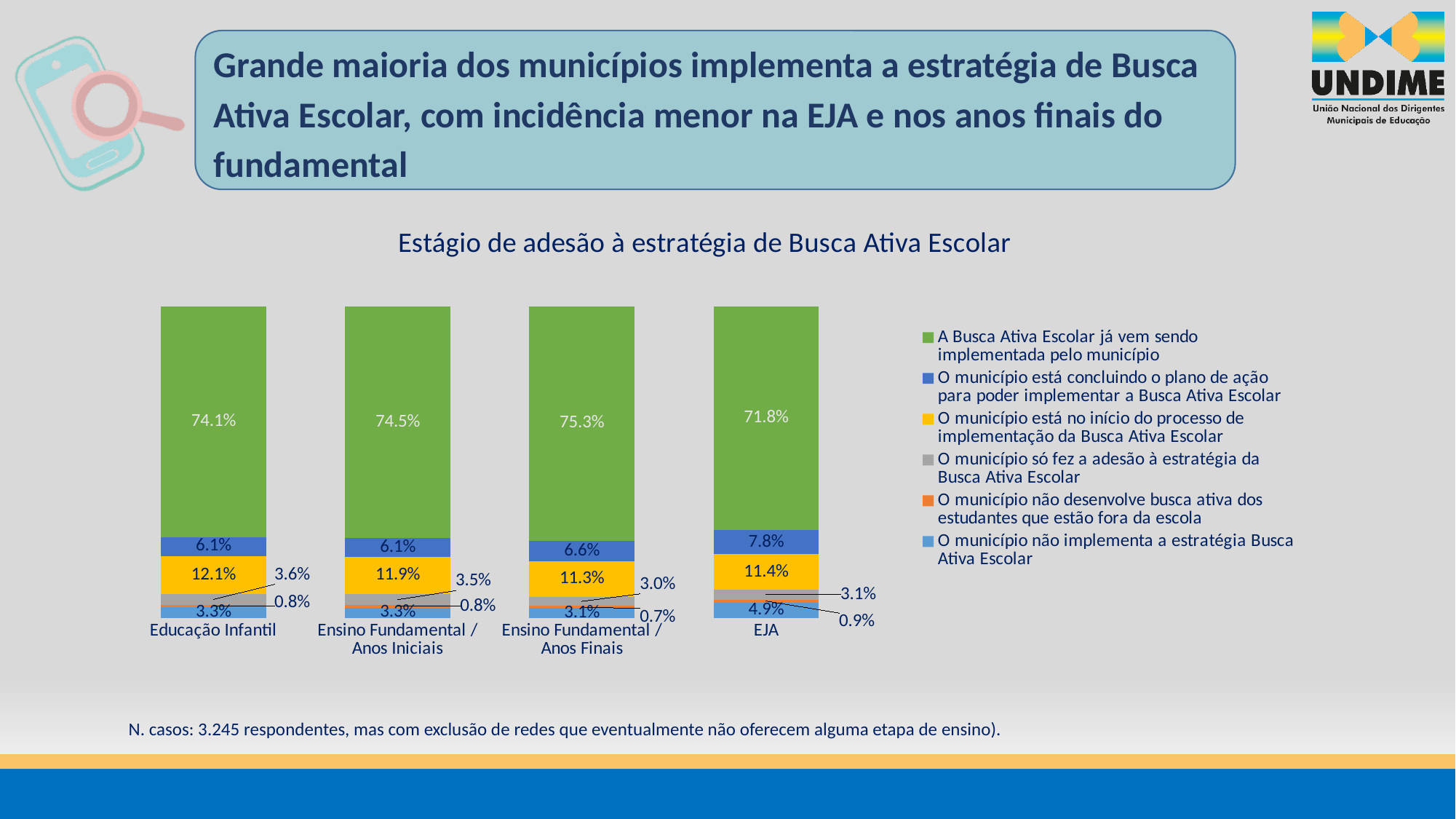
How many categories (education stages) are shown on the x axis? 4 What is the value for 'O município está concluindo o plano de ação para poder implementar a Busca Ativa Escolar' in the EJA bar? 7.8% What is the title of the chart? Estágio de adesão à estratégia de Busca Ativa Escolar Which category has the highest share of municipalities already implementing Busca Ativa Escolar? Ensino Fundamental / Anos Finais What is the value for 'O município não implementa a estratégia Busca Ativa Escolar' for EJA? 4.9% What percentage of municipalities in the Educação Infantil category report that Busca Ativa Escolar is already being implemented? 74.1% Which is larger: the 'não implementa a estratégia' share for EJA or for Educação Infantil? EJA What is the value for 'O município está no início do processo de implementação da Busca Ativa Escolar' for Ensino Fundamental / Anos Finais? 11.3% Which category has the lowest share of municipalities already implementing Busca Ativa Escolar? EJA What kind of chart is shown on the slide? Stacked bar chart What is the difference between the 'já vem sendo implementada' share for Ensino Fundamental / Anos Finais and for EJA? 3.5% How many series does the legend list? 6